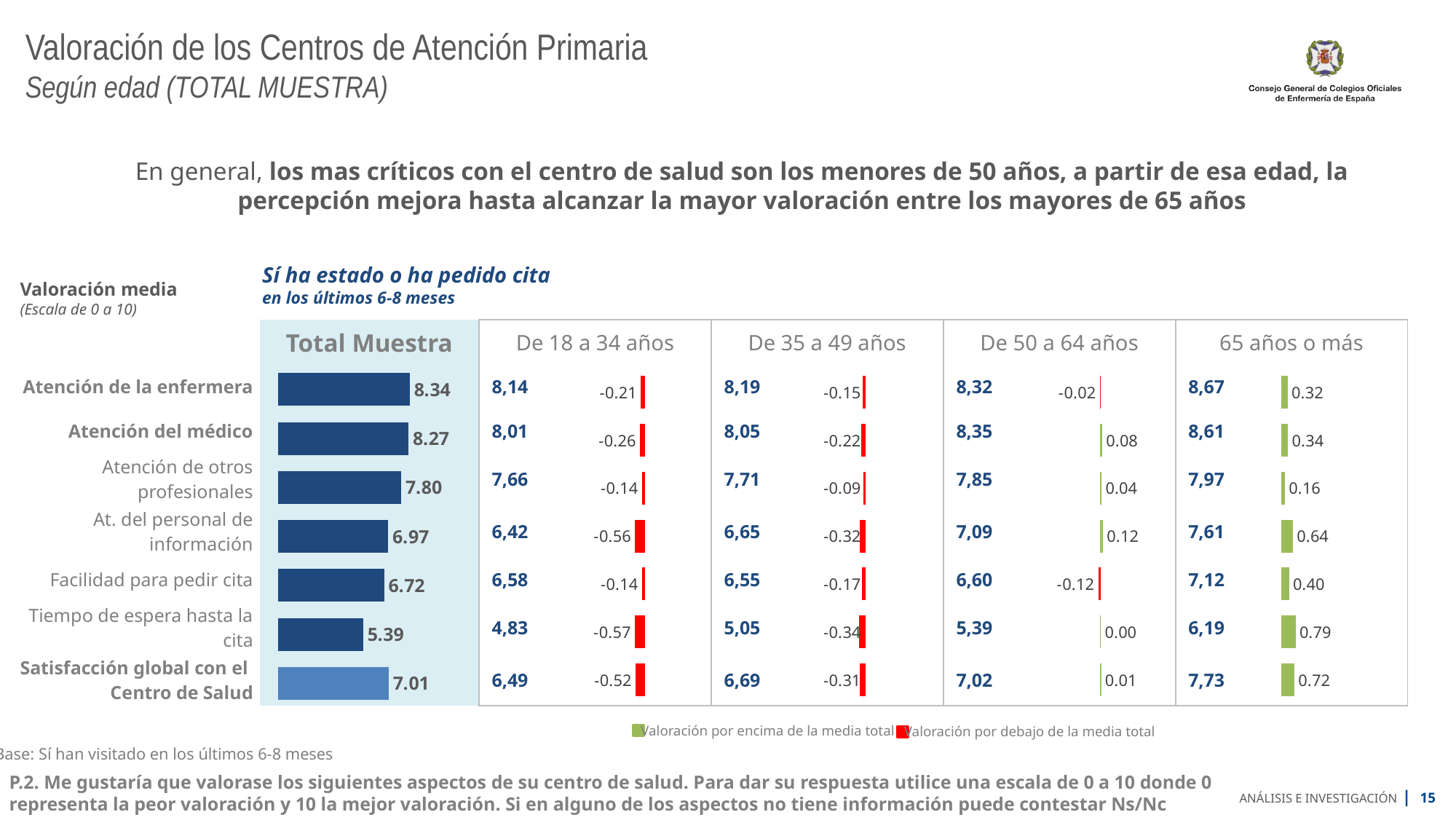
In the Total Muestra bar chart, which category has the lowest value? Tiempo de espera hasta la cita Which is larger for Satisfacción global con el Centro de Salud: the De 35 a 49 años value or the 65 años o más value? 65 años o más In the Total Muestra bar chart, which category has the highest value? Atención de la enfermera In the De 50 a 64 años column, what is the value for Atención del médico? 8,35 According to the legend, what does a green bar in the age-group columns indicate? Valoración por encima de la media total In the Total Muestra bar chart, is the value for Facilidad para pedir cita greater or less than 7? less What kind of chart is used for the Total Muestra column? Bar chart In the De 18 a 34 años column, what is the value for Tiempo de espera hasta la cita? 4,83 In the Total Muestra bar chart, what is the difference between Atención del médico (8.27) and Satisfacción global con el Centro de Salud (7.01)? 1.26 In the 65 años o más column, what is the deviation from the total mean for Tiempo de espera hasta la cita? 0.79 In the Total Muestra bar chart, how many categories are plotted? 7 In the Total Muestra bar chart, what is the value for Atención de la enfermera? 8.34